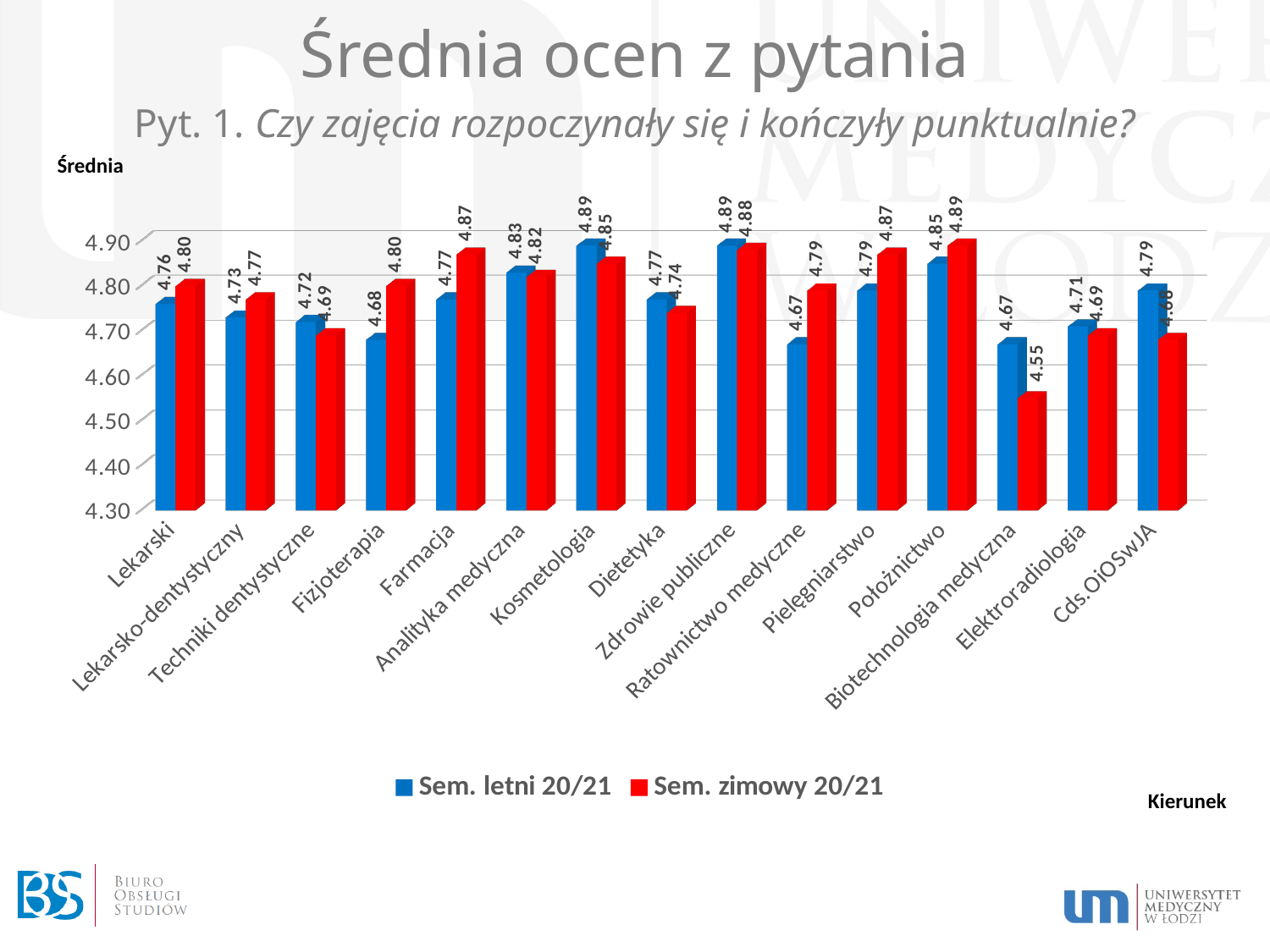
For Farmacja, which series has the larger value: Sem. letni 20/21 or Sem. zimowy 20/21? Sem. zimowy 20/21 What is the value for Ratownictwo medyczne in the Sem. letni 20/21 series? 4.67 What is the value for Pielęgniarstwo in the Sem. zimowy 20/21 series? 4.87 Which category has the lowest value in the Sem. zimowy 20/21 series? Biotechnologia medyczna What kind of chart is shown on the slide? bar chart How many categories (kierunki) are shown on the x axis? 15 How many series does the legend list? 2 Is the Sem. zimowy 20/21 value for Biotechnologia medyczna greater or less than 4.60? less What is the value for Farmacja in the Sem. zimowy 20/21 series? 4.87 Which category has the highest value in the Sem. zimowy 20/21 series? Położnictwo What is the difference between the Sem. zimowy 20/21 and Sem. letni 20/21 values for Fizjoterapia? 0.12 What is the value for Lekarski in the Sem. letni 20/21 series? 4.76